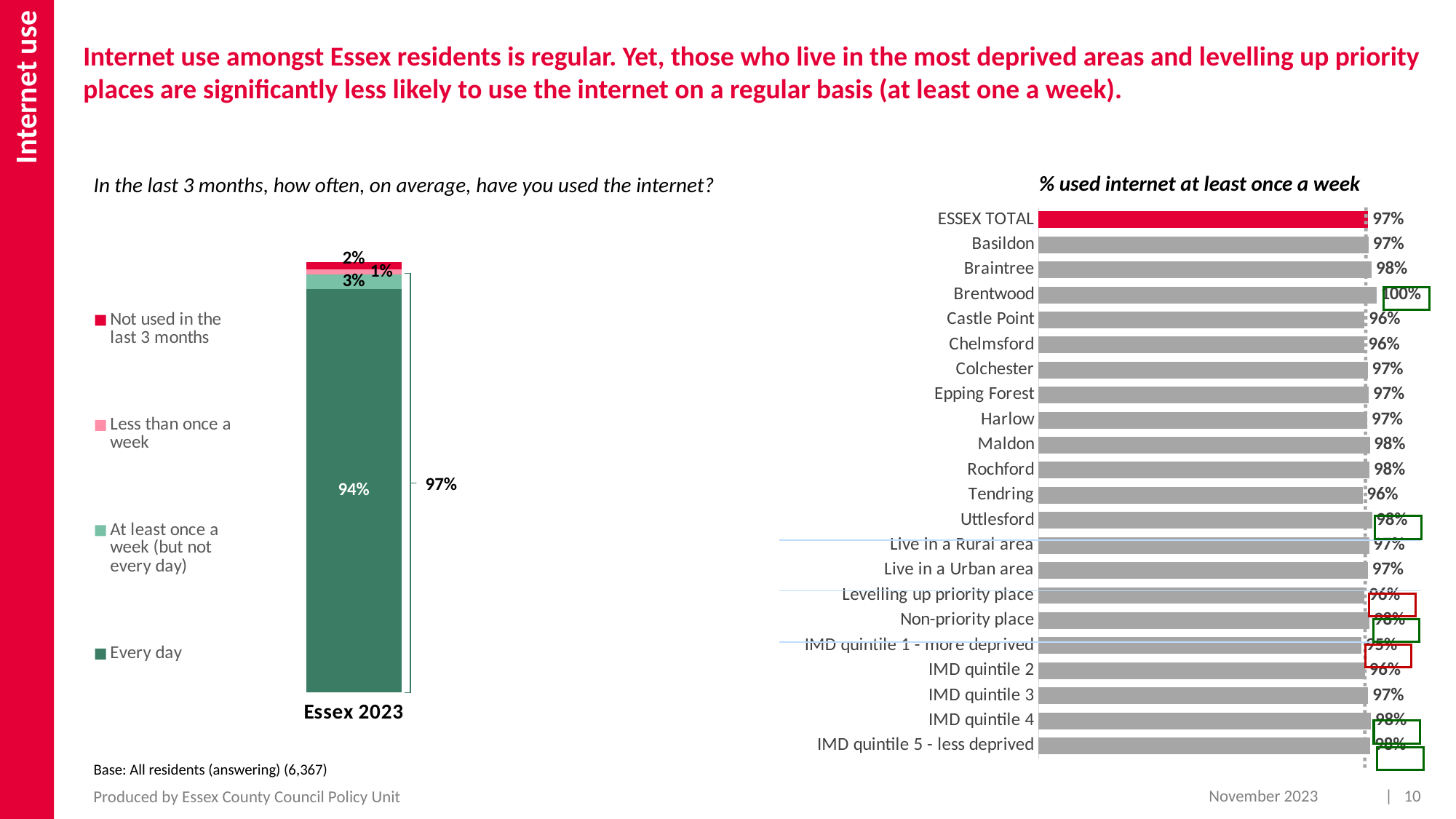
What kind of chart is the left chart? Stacked bar chart On the left chart, how many series does the legend list? 4 On the '% used internet at least once a week' chart, what is the value for IMD quintile 3? 97% On the left chart, what percentage of respondents had not used the internet in the last 3 months? 2% On the left chart, what percentage of Essex 2023 respondents use the internet every day? 94% On the left chart, what is the combined share of 'Every day' and 'At least once a week (but not every day)' shown by the bracket? 97% On the '% used internet at least once a week' chart, what is the value for Brentwood? 100% On the left chart, what percentage use the internet at least once a week (but not every day)? 3% On the '% used internet at least once a week' chart, what is the value for ESSEX TOTAL? 97% On the '% used internet at least once a week' chart, which category has the highest value? Brentwood On the '% used internet at least once a week' chart, what is the difference between Brentwood and Tendring? 4% On the '% used internet at least once a week' chart, which is larger, Maldon or Chelmsford? Maldon